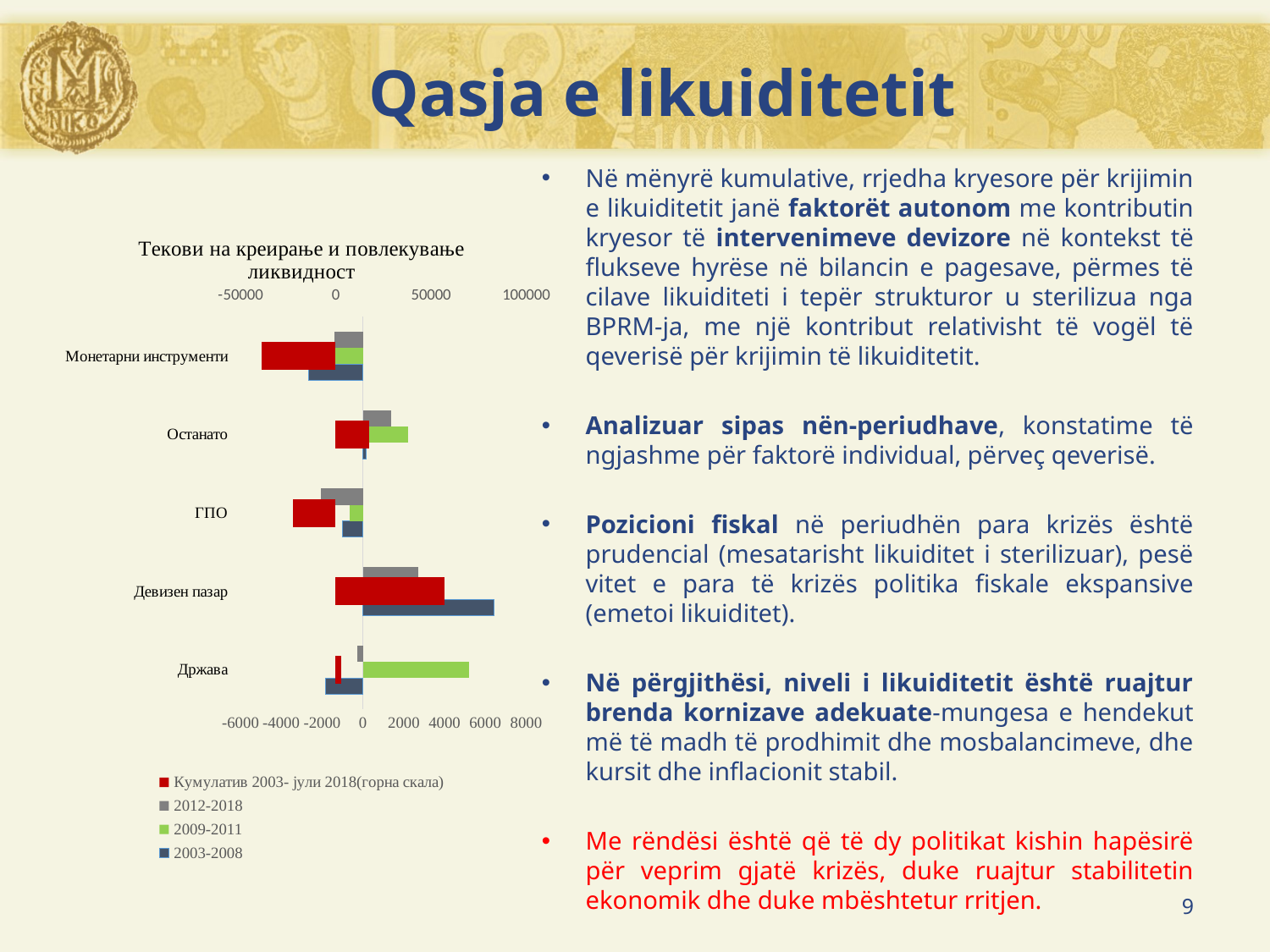
Which category has the lowest value for the Кумулатив 2003- јули 2018 series? Монетарни инструменти Which legend entry is shown in red? Кумулатив 2003- јули 2018(горна скала) Is the 2003-2008 value for Девизен пазар greater or less than 6000? greater What is the title of the chart? Текови на креирање и повлекување ликвидност Is the Кумулатив 2003- јули 2018 value for Девизен пазар greater or less than 50000 on the top scale? greater How many series does the chart legend list? 4 How many categories are plotted on the chart's vertical axis? 5 Which category has the highest value for the 2009-2011 series? Држава What kind of chart is shown on the slide? Bar chart Is the 2009-2011 value for Држава greater or less than 4000? greater Which category has the highest value for the 2003-2008 series? Девизен пазар For the 2003-2008 series, which is larger: the value for Девизен пазар or the value for Монетарни инструменти? Девизен пазар